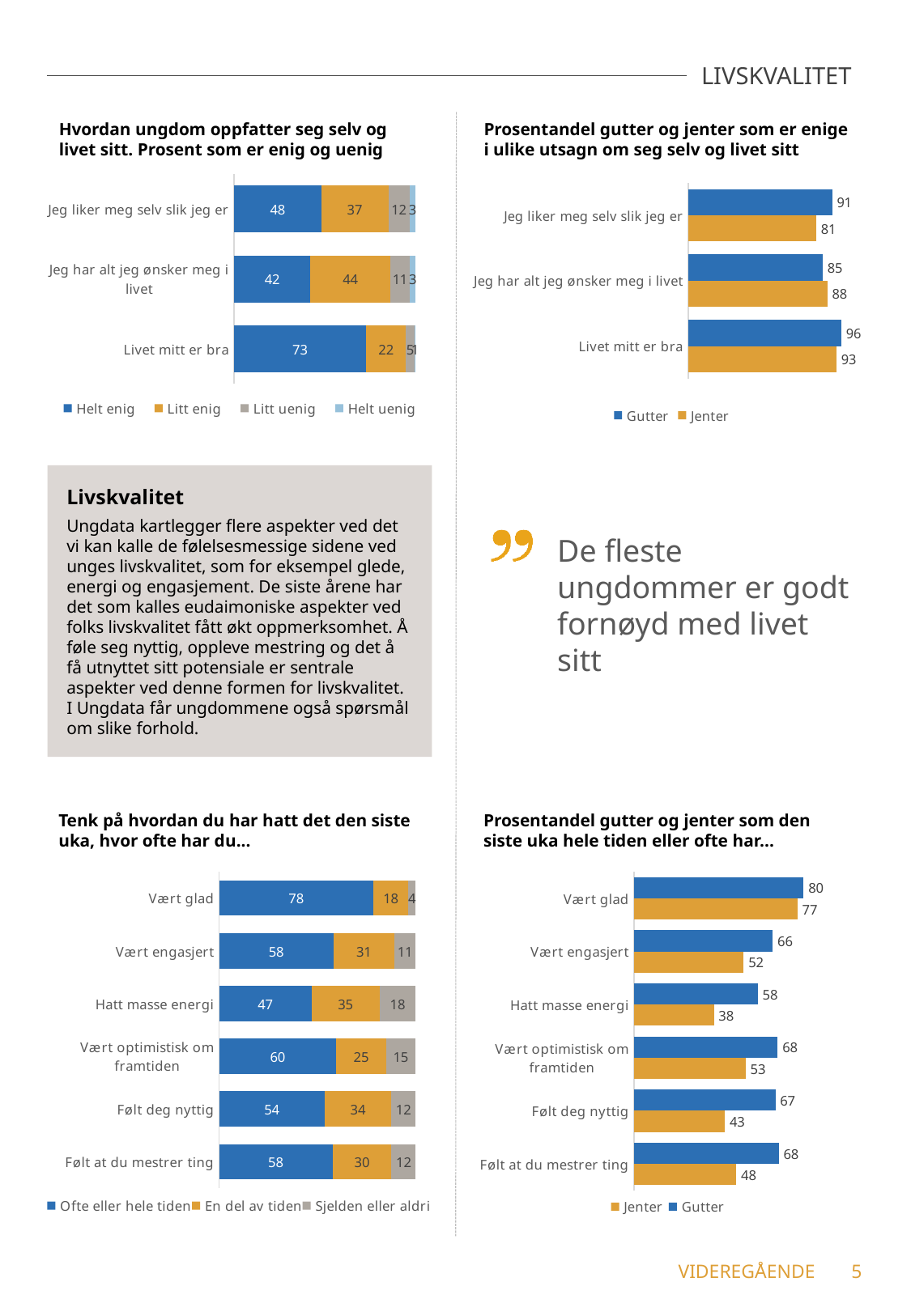
In the bottom-right chart 'Prosentandel gutter og jenter som den siste uka hele tiden eller ofte har...', what is the difference between Gutter and Jenter for 'Hatt masse energi'? 20 In the bottom-left chart 'Tenk på hvordan du har hatt det den siste uka, hvor ofte har du...', what is the 'En del av tiden' value for 'Hatt masse energi'? 35 In the top-left chart 'Hvordan ungdom oppfatter seg selv og livet sitt', what is the total of the stacked bar for 'Jeg liker meg selv slik jeg er'? 100 In the top-left chart 'Hvordan ungdom oppfatter seg selv og livet sitt', what is the 'Helt enig' value for 'Livet mitt er bra'? 73 In the top-right chart 'Prosentandel gutter og jenter som er enige i ulike utsagn om seg selv og livet sitt', what is the value for Jenter on 'Jeg liker meg selv slik jeg er'? 81 In the top-right chart 'Prosentandel gutter og jenter som er enige i ulike utsagn om seg selv og livet sitt', which is larger for 'Jeg har alt jeg ønsker meg i livet', Gutter or Jenter? Jenter In the top-left chart 'Hvordan ungdom oppfatter seg selv og livet sitt', how many series does the legend list? 4 In the bottom-right chart 'Prosentandel gutter og jenter som den siste uka hele tiden eller ofte har...', what is the value for Jenter on 'Følt deg nyttig'? 43 In the top-right chart 'Prosentandel gutter og jenter som er enige i ulike utsagn om seg selv og livet sitt', what is the difference between Gutter and Jenter for 'Livet mitt er bra'? 3 What kind of chart is the bottom-right chart 'Prosentandel gutter og jenter som den siste uka hele tiden eller ofte har...'? Bar chart In the bottom-left chart 'Tenk på hvordan du har hatt det den siste uka, hvor ofte har du...', which category has the highest 'Ofte eller hele tiden' value? Vært glad In the bottom-left chart 'Tenk på hvordan du har hatt det den siste uka, hvor ofte har du...', how many categories are shown? 6